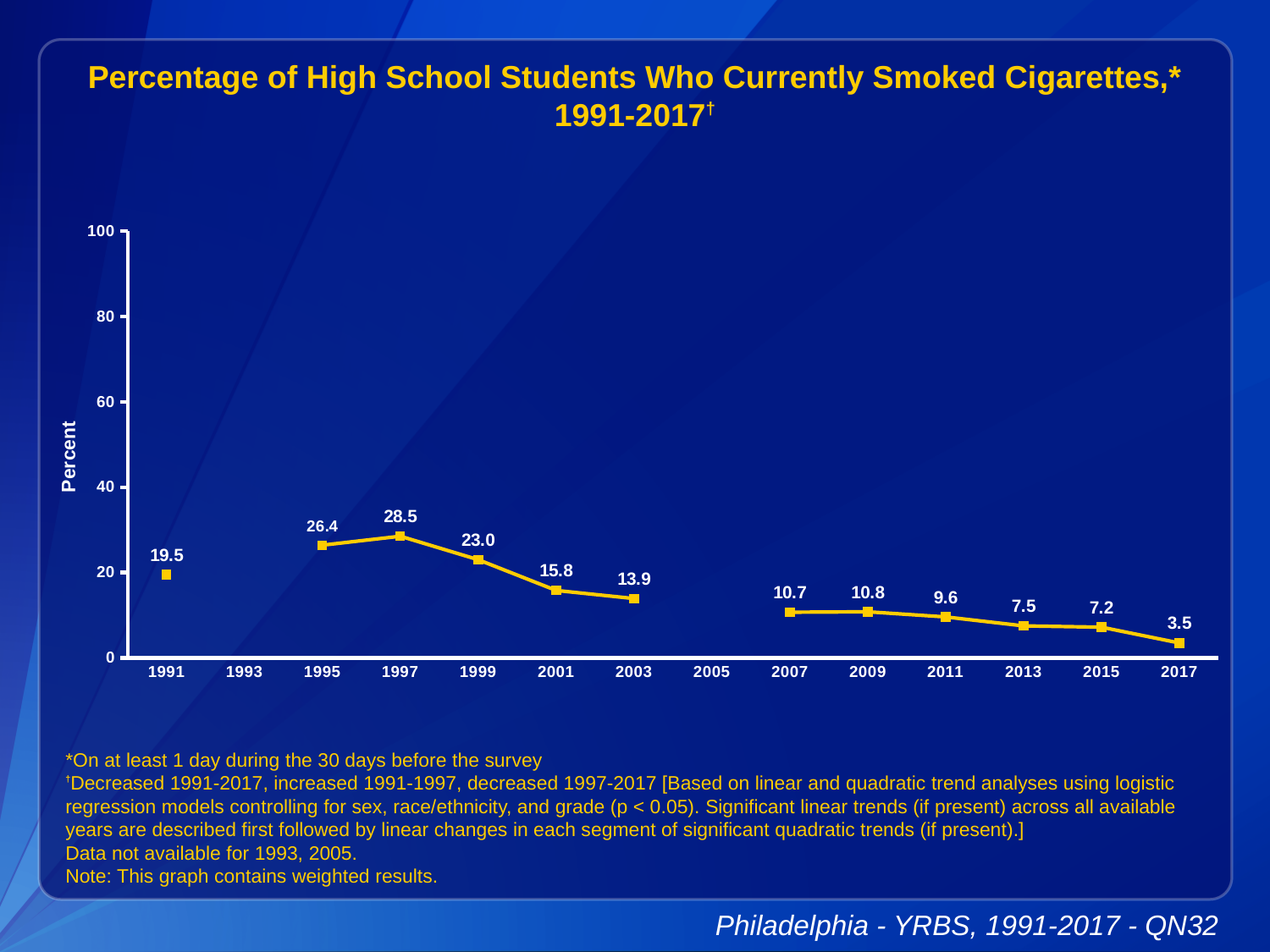
What percentage of high school students currently smoked cigarettes in 1997? 28.5 Which year has a larger value, 2001 or 2009? 2001 What is the value plotted for 1991? 19.5 Is the value for 1997 greater or less than 20? greater How many data points are plotted on the chart? 12 Which year has the highest percentage of students who currently smoked cigarettes? 1997 What is the difference between the values for 1997 and 2017? 25.0 What is the value plotted for 2017? 3.5 What kind of chart is shown on the slide? Line chart What is the difference between the values for 1995 and 1999? 3.4 Which year has the lowest percentage of students who currently smoked cigarettes? 2017 Do the values rise or fall from 1997 to 2017? Fall